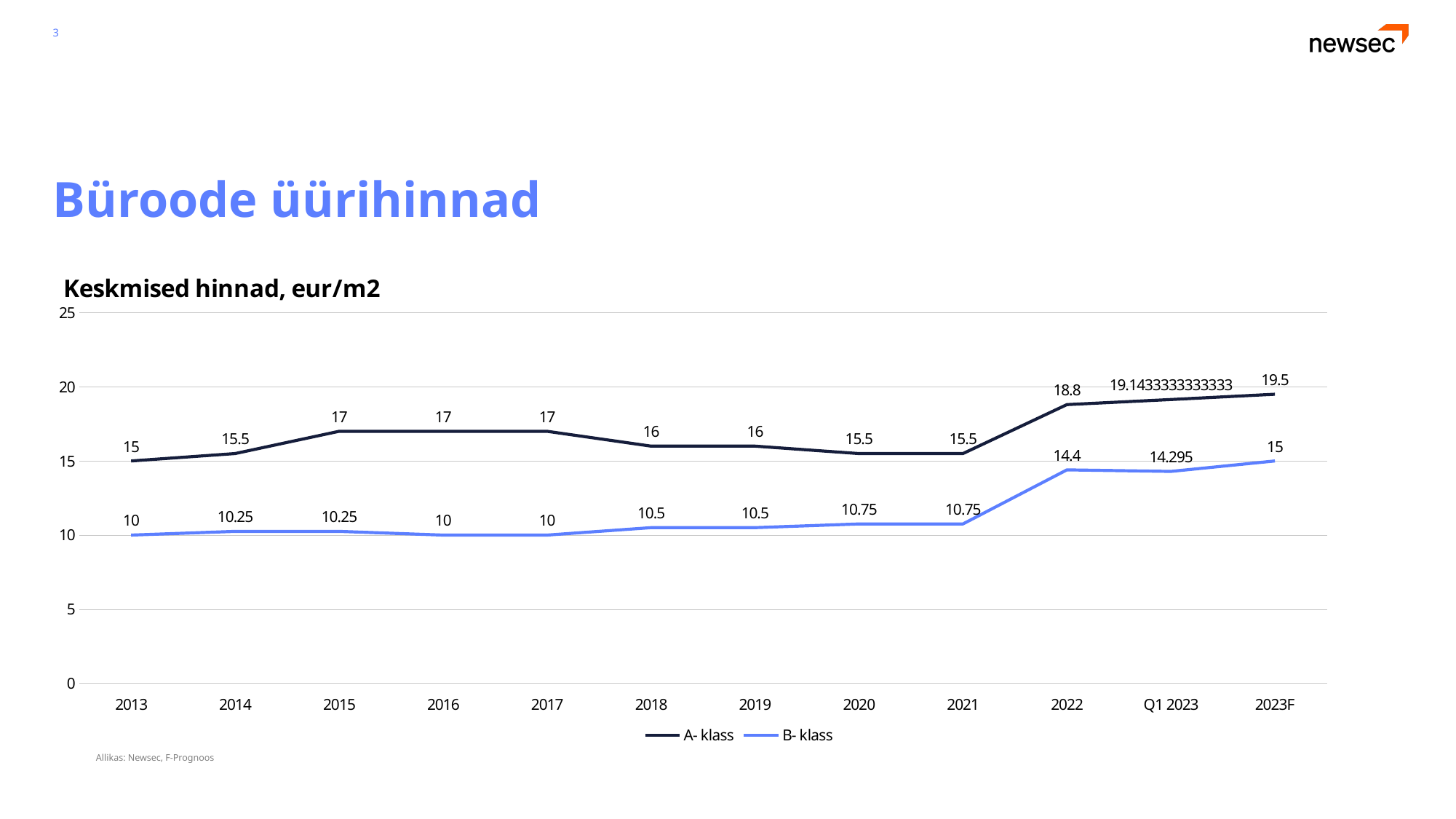
What is the difference between the A- klass and B- klass values in 2022? 4.4 What is the B- klass value for 2020? 10.75 Which is larger in 2018: the A- klass value or the B- klass value? A- klass What is the A- klass value for Q1 2023? 19.1433333333333 How many x-axis categories are plotted in the chart? 12 What is the title of the chart? Keskmised hinnad, eur/m2 What is the A- klass value for 2015? 17 What kind of chart is shown on the slide? Line chart What is the lowest value shown for the B- klass series? 10 What is the B- klass value for 2023F? 15 How many series does the legend list? 2 In which year does the A- klass series reach its highest value? 2023F